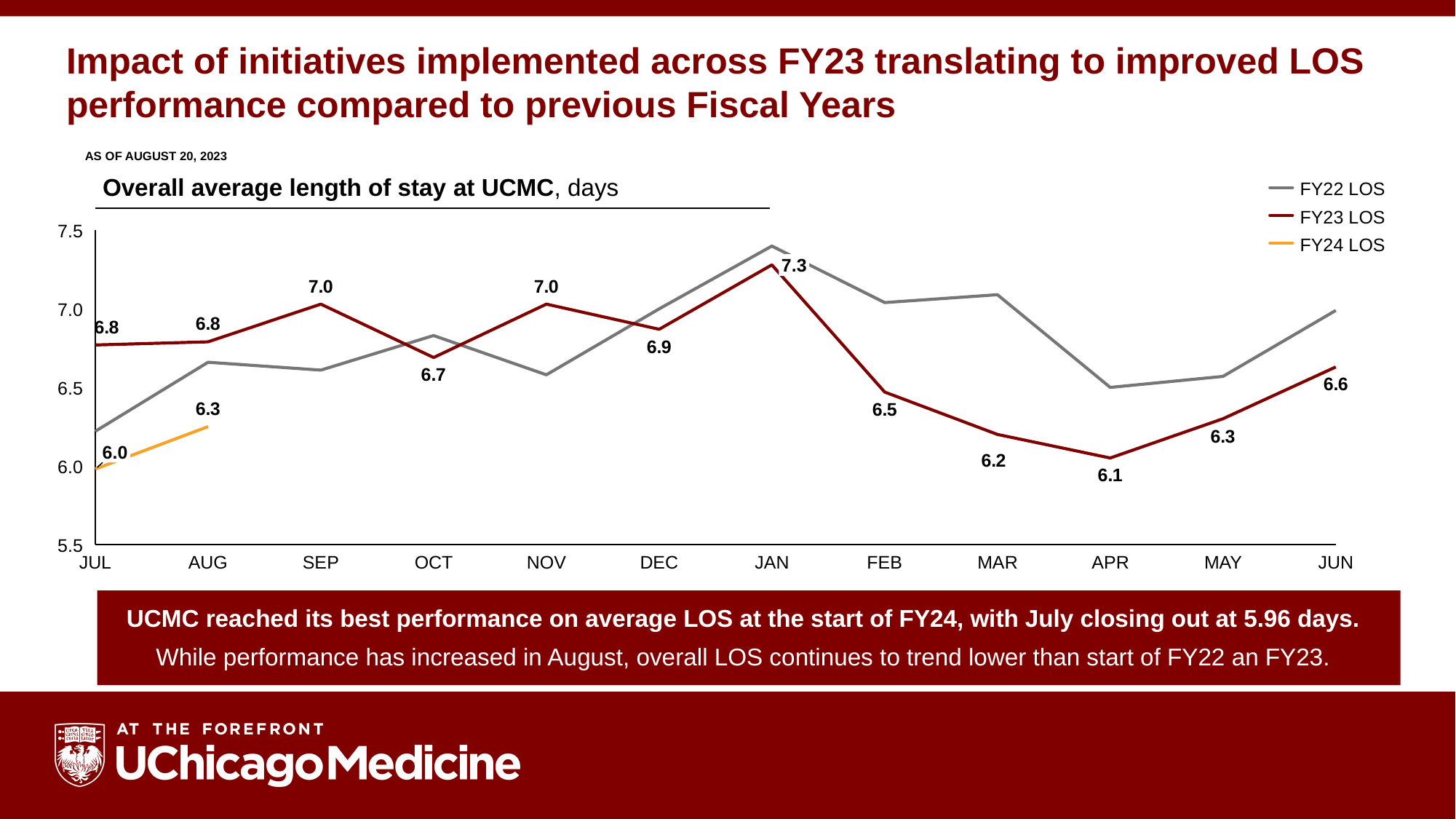
How many months are shown on the x axis? 12 Which is larger for JUL: the FY23 LOS or the FY24 LOS? FY23 LOS Does the FY24 LOS rise or fall from JUL to AUG? Rise What is the difference between the FY23 LOS in JAN and in APR? 1.2 How many series does the legend list? 3 Is the FY22 LOS value for JAN greater or less than 7.0? greater What is the FY23 LOS value for JAN? 7.3 What is the FY24 LOS value for AUG? 6.3 In which month is the FY23 LOS highest? JAN What kind of chart is shown on the slide? Line chart In which month is the FY23 LOS lowest? APR Is the FY22 LOS value for JUL greater or less than 6.5? less